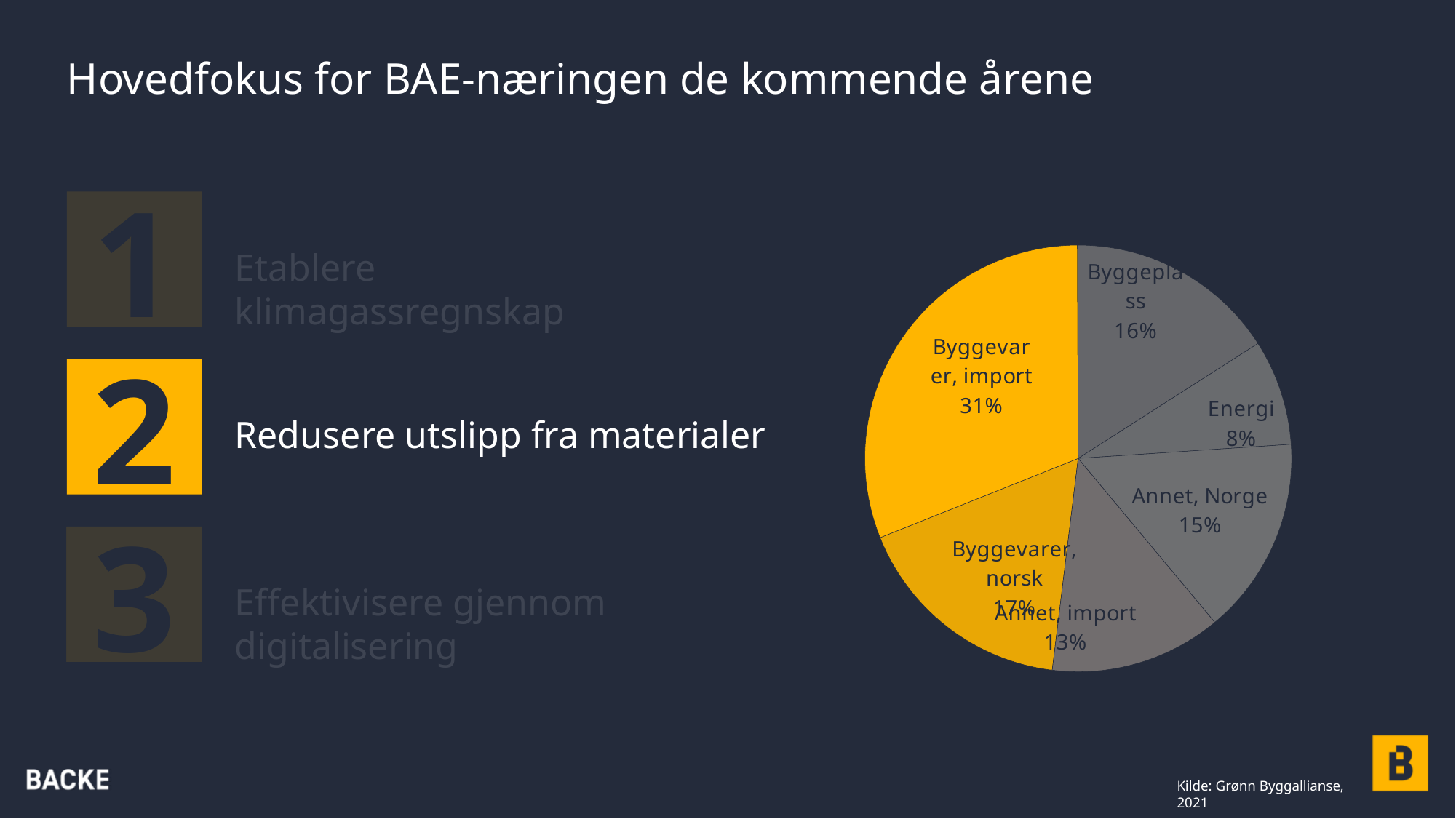
Which slice of the pie chart is the largest? Byggevarer, import Which two slices of the pie chart are coloured yellow/orange rather than grey? Byggevarer, import and Byggevarer, norsk What is the difference between the shares of "Byggevarer, import" and "Byggevarer, norsk"? 14 percentage points How many slices does the pie chart have? 6 What is the value shown for "Byggeplass"? 16% What kind of chart is shown on the slide? Pie chart What is the value shown for "Energi"? 8% Which slice of the pie chart is the smallest? Energi What is the value shown for "Byggevarer, norsk"? 17% What is the value shown for "Annet, Norge"? 15% What share of the pie does "Byggevarer, import" represent? 31% Which is larger, the share for "Byggeplass" or the share for "Annet, import"? Byggeplass